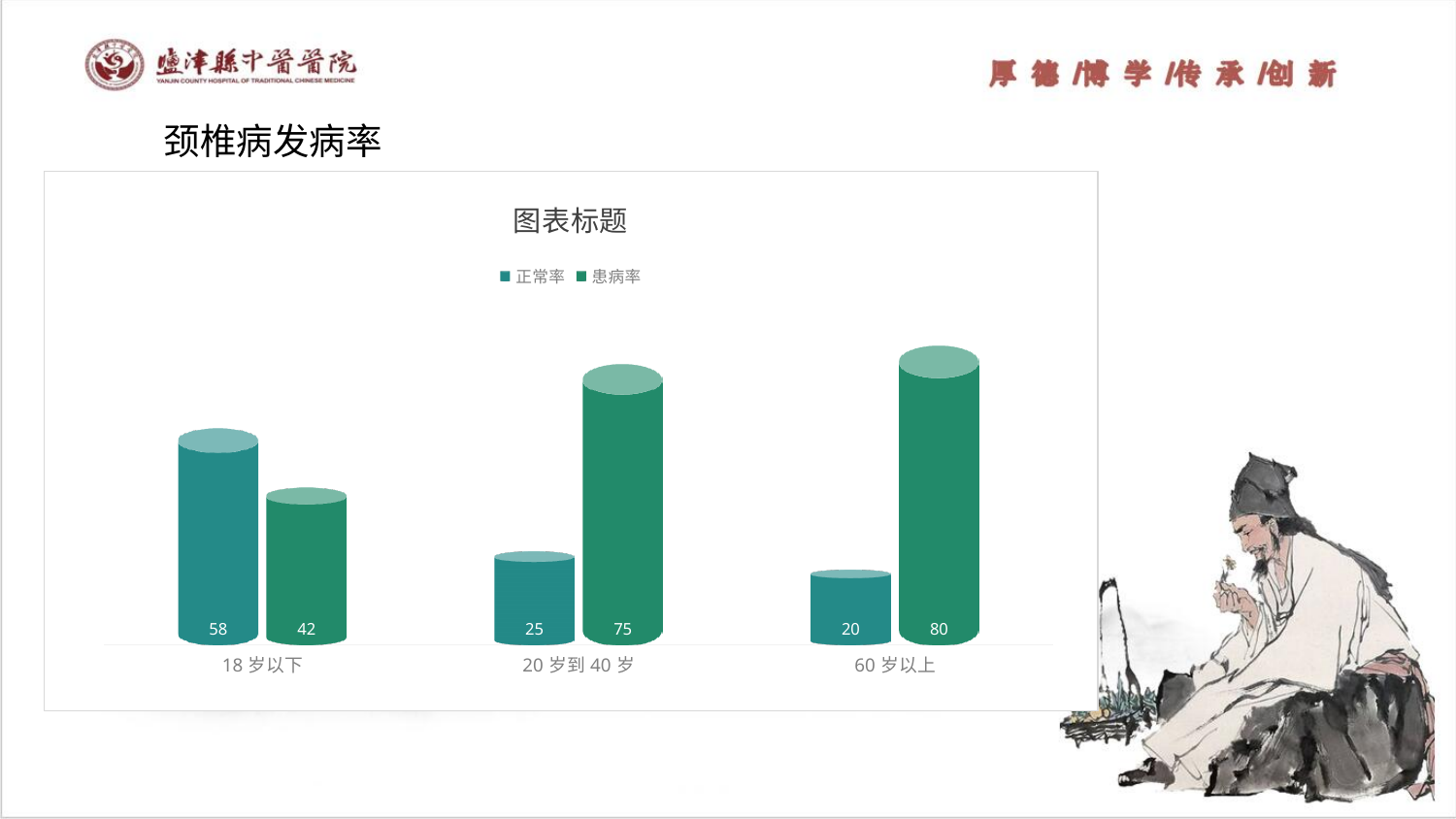
What is the 患病率 value for 20 岁到 40 岁? 75 Does the 患病率 rise or fall across the categories from left to right? rise What is the 患病率 value for 60 岁以上? 80 How many age categories are shown on the x axis? 3 What is the difference between 患病率 and 正常率 for 20 岁到 40 岁? 50 Which is larger for 18 岁以下, 正常率 or 患病率? 正常率 What kind of chart is shown on the slide? bar chart What is the title shown above the chart? 图表标题 Which category has the lowest 正常率? 60 岁以上 What is the 正常率 value for 18 岁以下? 58 Which category has the highest 患病率? 60 岁以上 How many series does the legend list? 2